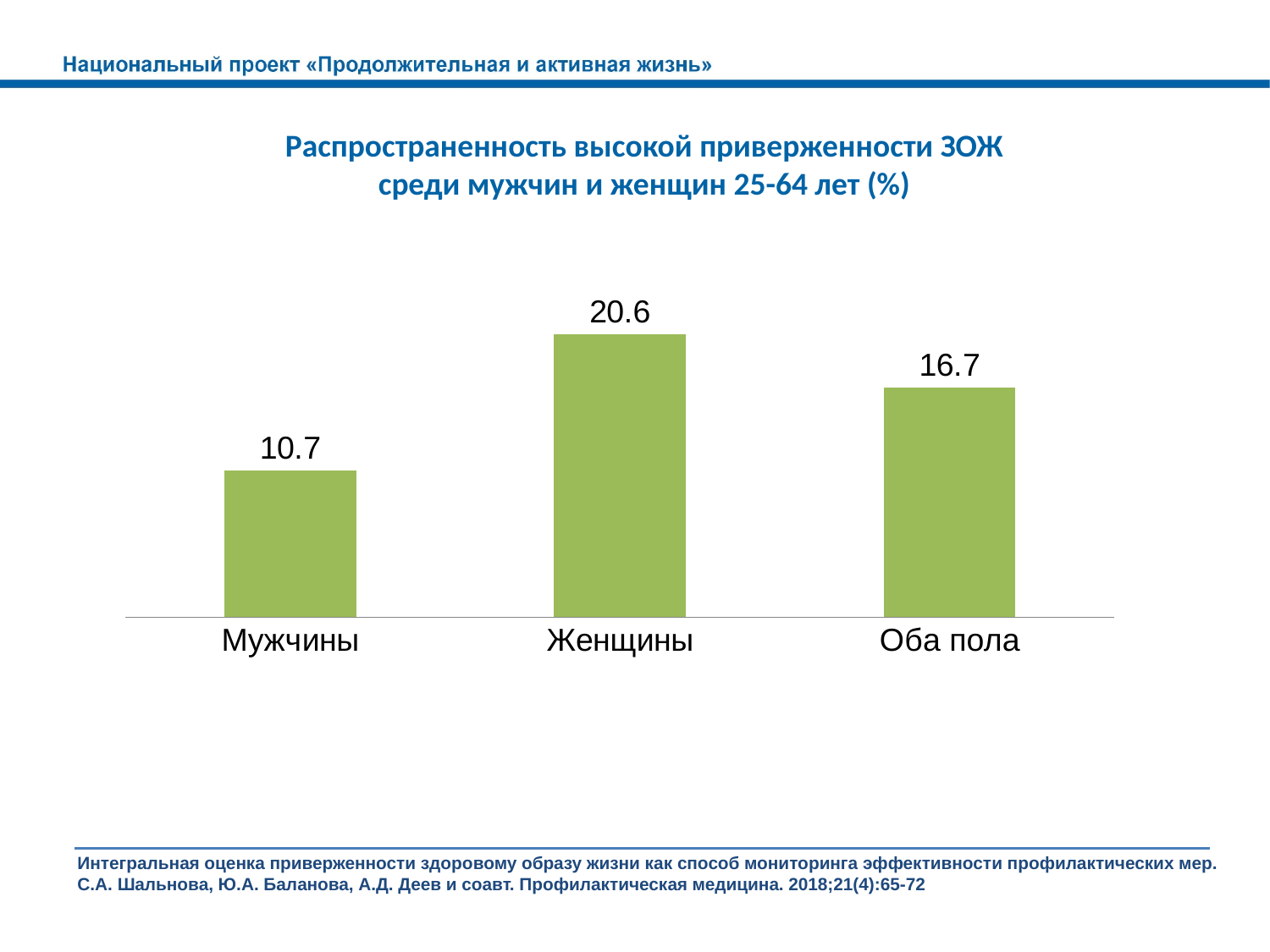
What colour are the bars in the chart? green How many categories are shown in the chart? 3 What kind of chart is shown on the slide? bar chart What is the value for Мужчины? 10.7 What is the difference between the values for Женщины and Мужчины? 9.9 What is the title of the chart? Распространенность высокой приверженности ЗОЖ среди мужчин и женщин 25-64 лет (%) Which category has the highest value? Женщины Which is larger, the value for Мужчины or the value for Оба пола? Оба пола What is the value for Женщины? 20.6 What is the value for Оба пола? 16.7 What is the difference between the values for Женщины and Оба пола? 3.9 Which category has the lowest value? Мужчины